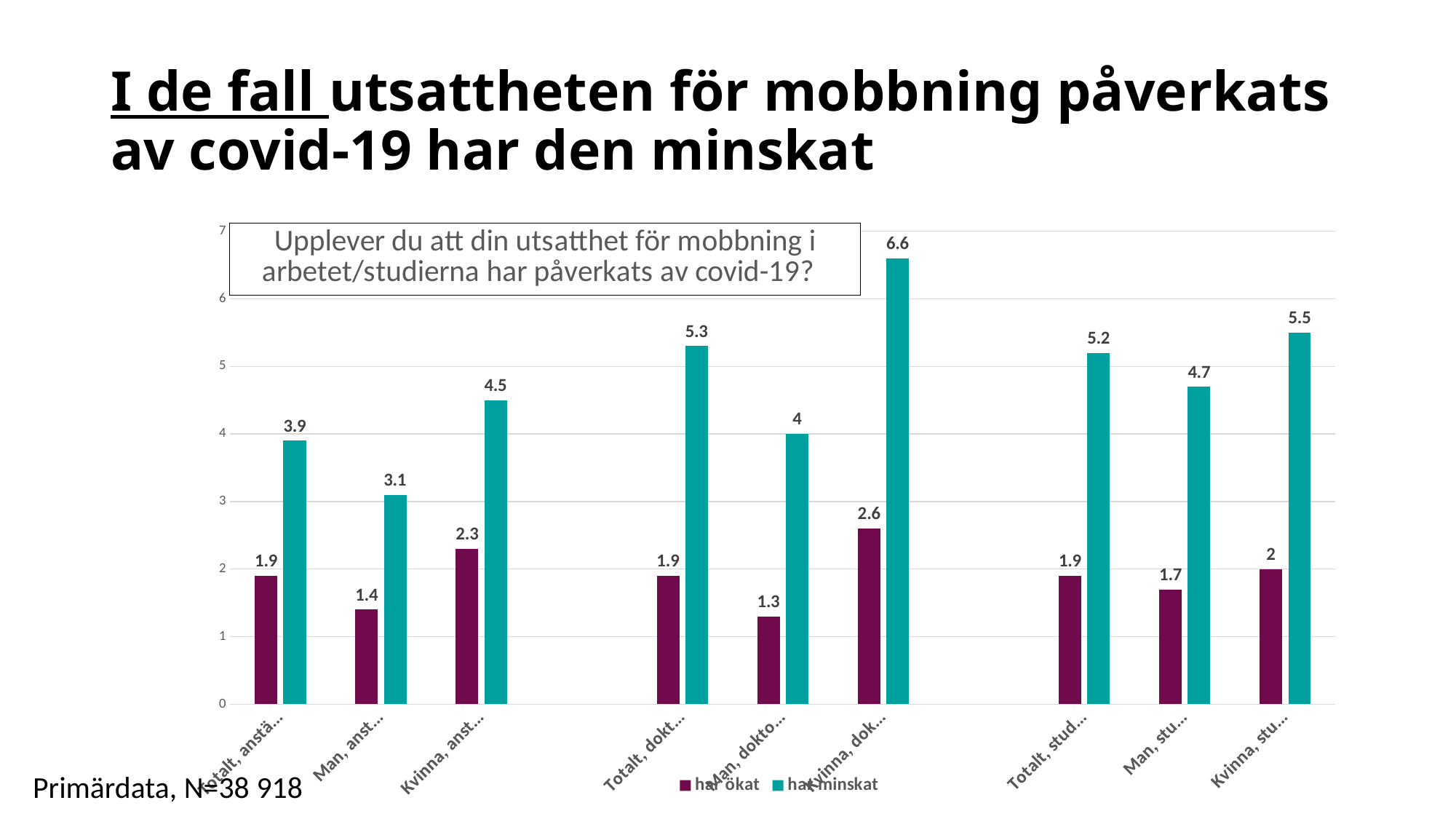
What is the difference between 'har minskat' and 'har ökat' for the category 'Totalt, dokt...'? 3.4 What is the value of 'har minskat' for the category 'Kvinna, dok...'? 6.6 Which is larger: the 'har minskat' value for 'Kvinna, stu...' or for 'Totalt, stud...'? Kvinna, stu... Which category has the lowest 'har ökat' value? Man, dokto... How many categories are shown on the x axis? 9 What is the question text shown in the box at the top of the chart? Upplever du att din utsatthet för mobbning i arbetet/studierna har påverkats av covid-19? Which category has the highest 'har minskat' value? Kvinna, dok... What is the value of 'har ökat' for the category 'Man, dokto...'? 1.3 What type of chart is shown on the slide? bar chart How many series does the legend list? 2 What is the value of 'har minskat' for the category 'Man, anst...'? 3.1 What are the two series named in the legend? har ökat, har minskat